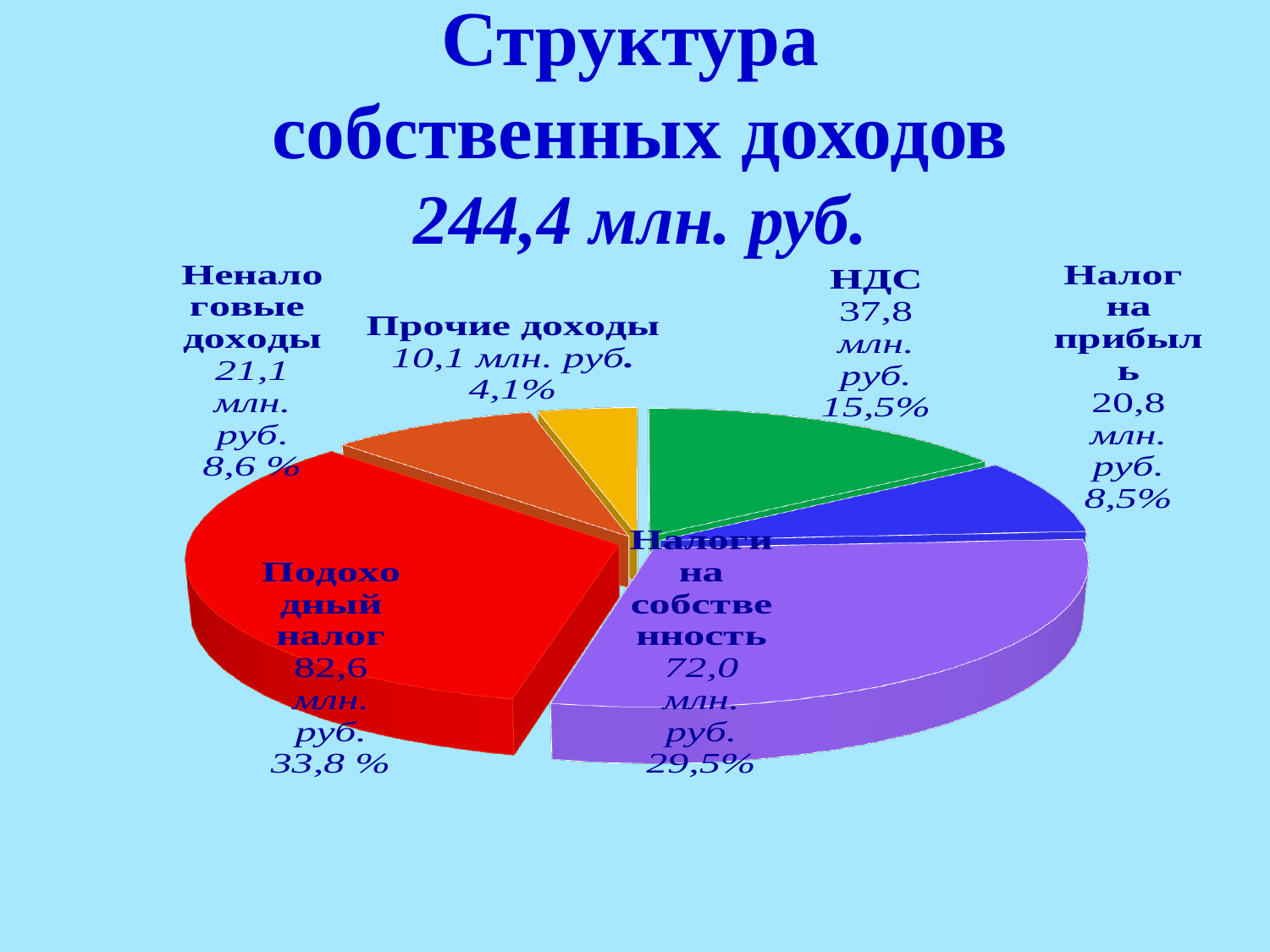
What is the value for Прочие доходы? 10,1 млн. руб. What share of the pie does Неналоговые доходы take? 8,6 % Which category has the smallest slice? Прочие доходы What total amount is stated in the chart title? 244,4 млн. руб. What share of the pie does Налоги на собственность take? 29,5% How many slices does the pie chart have? 6 What is the value for НДС? 37,8 млн. руб. What kind of chart is shown on the slide? pie chart Which category has the largest slice? Подоходный налог What is the difference between Подоходный налог and Налоги на собственность in млн. руб.? 10,6 млн. руб. What is the value for Подоходный налог? 82,6 млн. руб. Which is larger, НДС or Налог на прибыль? НДС